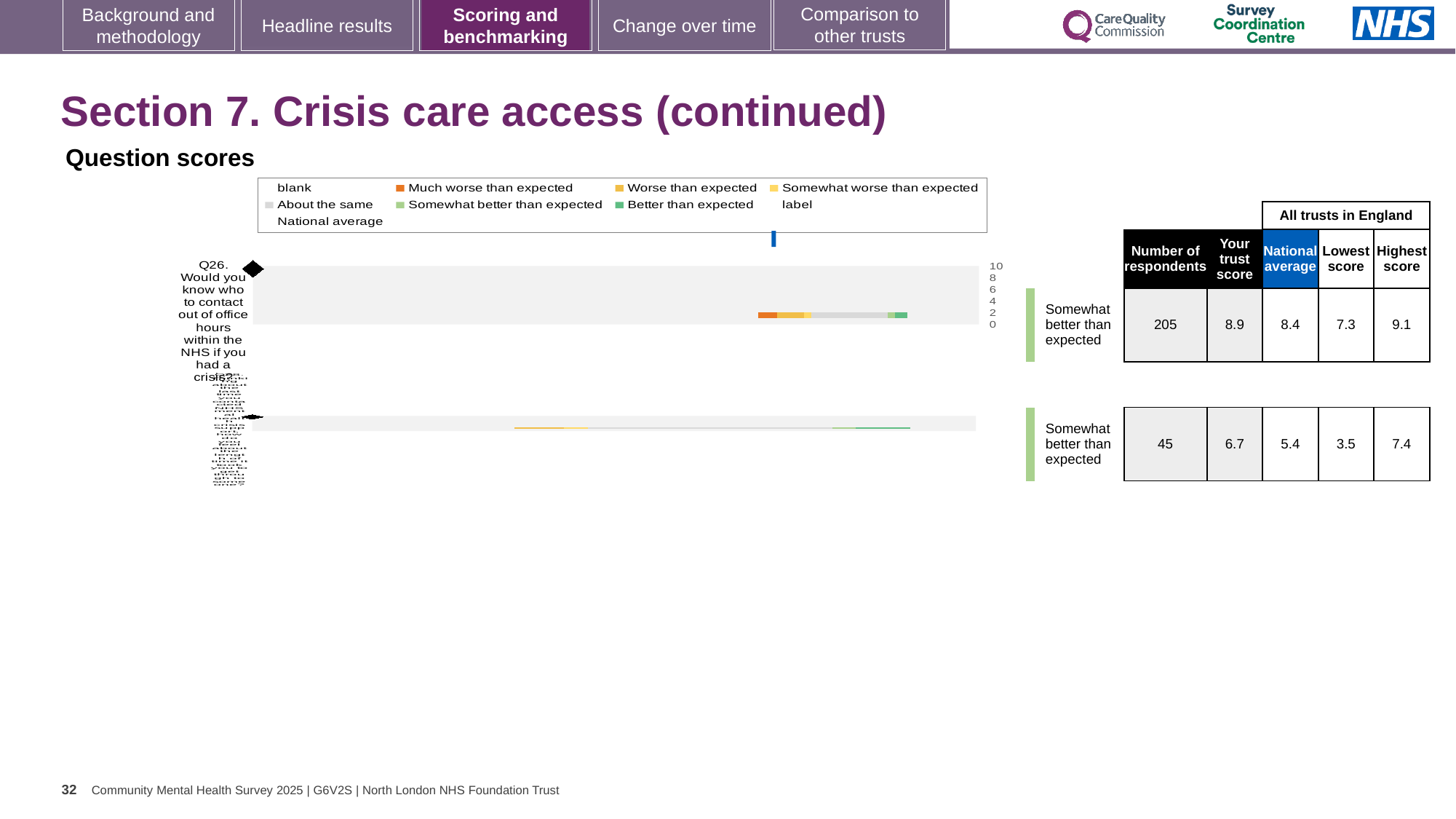
What is the lowest score among all trusts in England for Q26? 7.3 Which colour does the legend use for 'Much worse than expected'? orange What is the difference between the trust score and the national average for Q26? 0.5 What is the trust score for Q26 (Would you know who to contact out of office hours within the NHS if you had a crisis?)? 8.9 For Q26, is the trust score higher or lower than the national average? higher How many respondents answered Q26? 205 What is the maximum value shown on the chart's score axis? 10 What benchmarking category is Q26 placed in? Somewhat better than expected What is the highest score among all trusts in England for Q26? 9.1 What is the national average for Q26? 8.4 What kind of chart is shown under 'Question scores'? bar chart